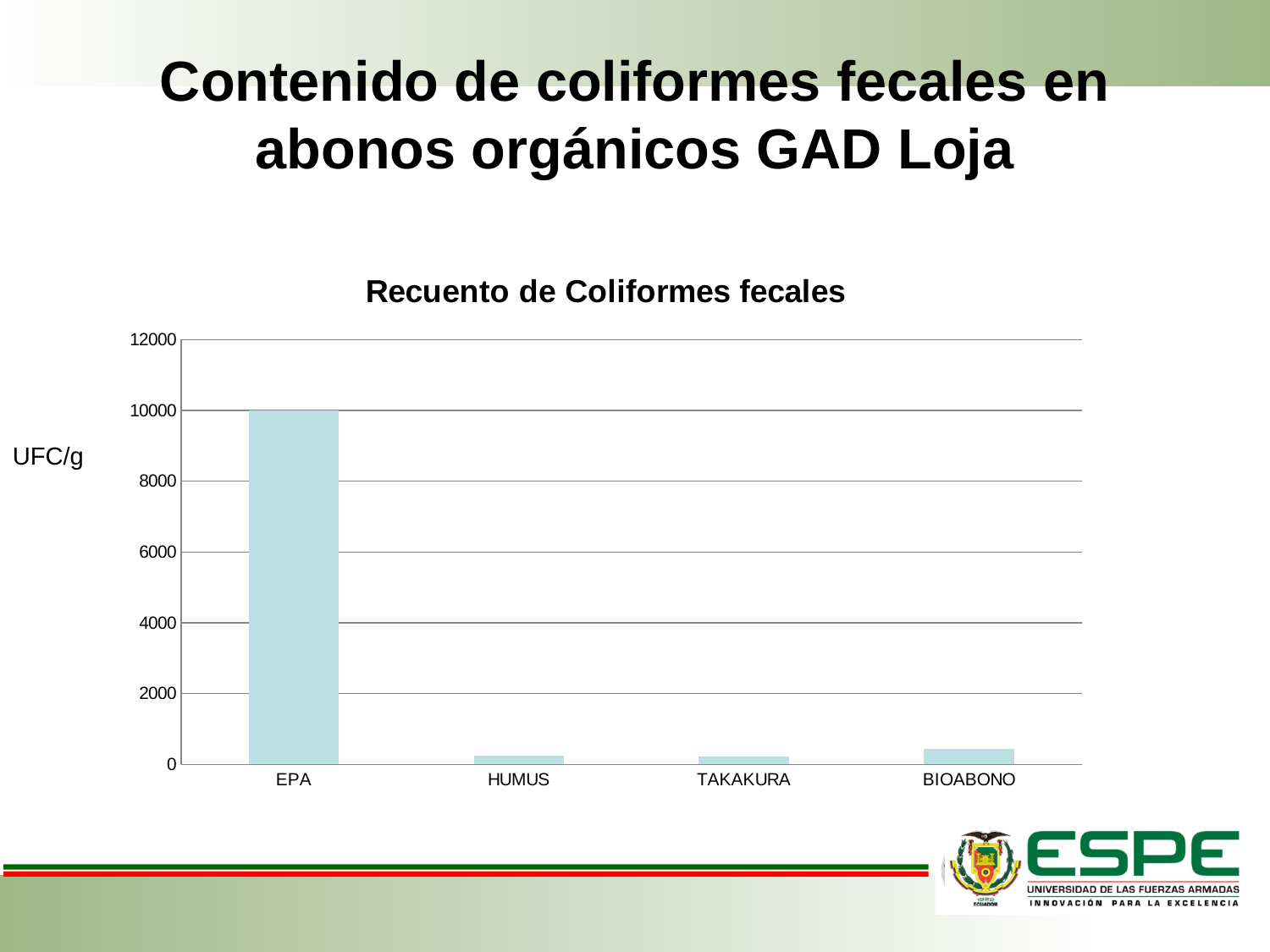
What is the value for EPA in the chart? 10000 Is the value for HUMUS greater or less than 2000? less Which is larger, the value for EPA or the value for BIOABONO? EPA What kind of chart is shown on the slide? bar chart What unit is shown on the vertical axis of the chart? UFC/g Is the value for EPA greater or less than 8000? greater What is the title of the chart? Recuento de Coliformes fecales Is the value for BIOABONO greater or less than 2000? less How many categories are shown on the x axis of the chart? 4 Which is larger, the value for BIOABONO or the value for TAKAKURA? BIOABONO Which category has the highest value in the chart? EPA